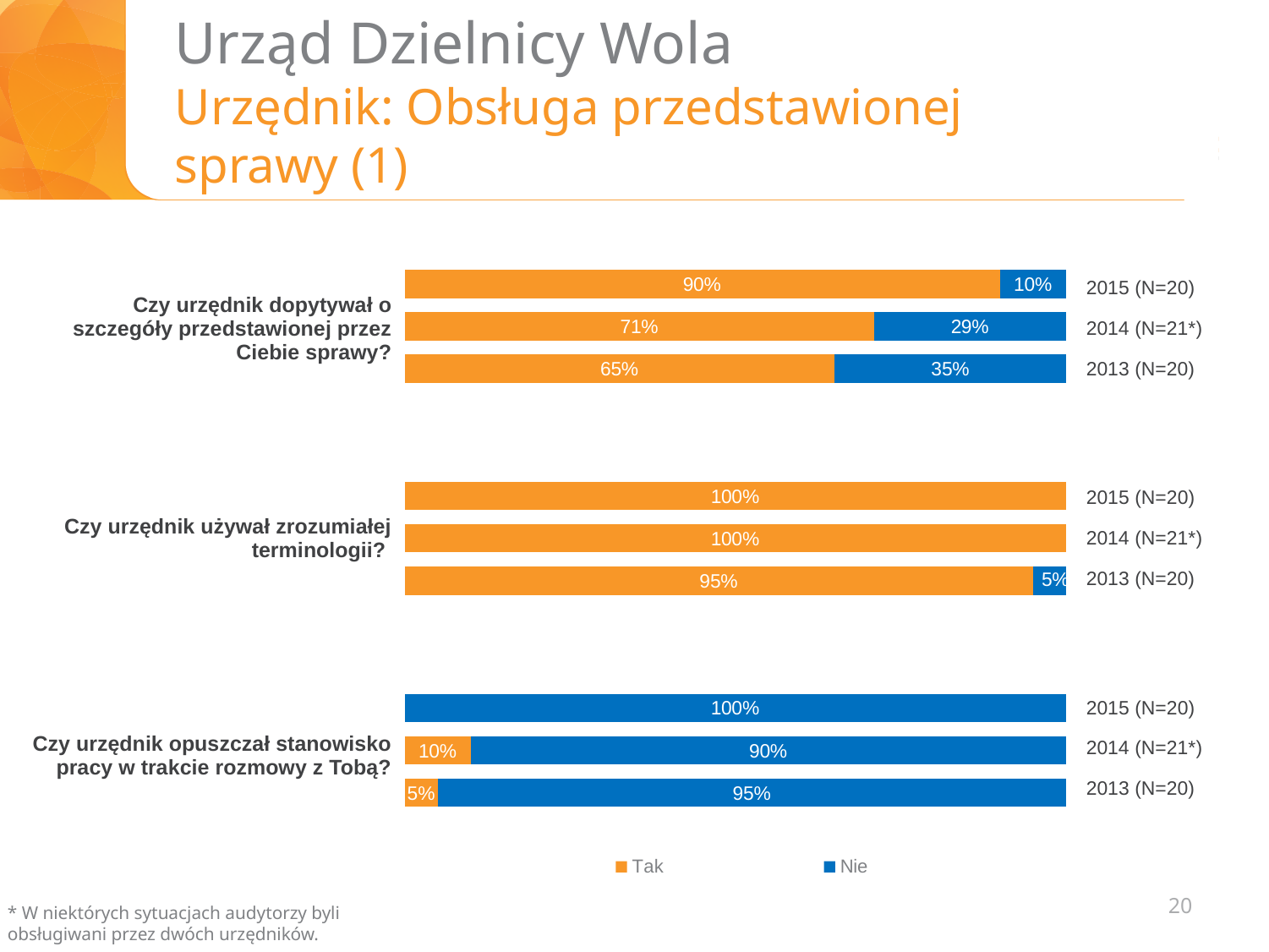
What kind of chart is used on the slide? Stacked bar chart In the chart for "Czy urzędnik dopytywał o szczegóły przedstawionej przez Ciebie sprawy?", what is the difference between the "Tak" values for 2015 (N=20) and 2013 (N=20)? 25 percentage points In the chart for "Czy urzędnik opuszczał stanowisko pracy w trakcie rozmowy z Tobą?", what is the total of the stacked bar for 2013 (N=20)? 100% In the chart for "Czy urzędnik dopytywał o szczegóły przedstawionej przez Ciebie sprawy?", what is the "Tak" value for 2015 (N=20)? 90% How many series does the legend list? 2 In the chart for "Czy urzędnik opuszczał stanowisko pracy w trakcie rozmowy z Tobą?", is the "Tak" value for 2014 (N=21*) larger or smaller than the "Tak" value for 2013 (N=20)? larger In the chart for "Czy urzędnik używał zrozumiałej terminologii?", what is the "Tak" value for 2013 (N=20)? 95% In the chart for "Czy urzędnik dopytywał o szczegóły przedstawionej przez Ciebie sprawy?", which year has the highest "Tak" value? 2015 (N=20) In the chart for "Czy urzędnik dopytywał o szczegóły przedstawionej przez Ciebie sprawy?", what is the "Nie" value for 2013 (N=20)? 35% In the chart for "Czy urzędnik używał zrozumiałej terminologii?", which year has the lowest "Tak" value? 2013 (N=20) How many year bars are shown in the chart for "Czy urzędnik dopytywał o szczegóły przedstawionej przez Ciebie sprawy?"? 3 In the chart for "Czy urzędnik opuszczał stanowisko pracy w trakcie rozmowy z Tobą?", what is the "Nie" value for 2014 (N=21*)? 90%